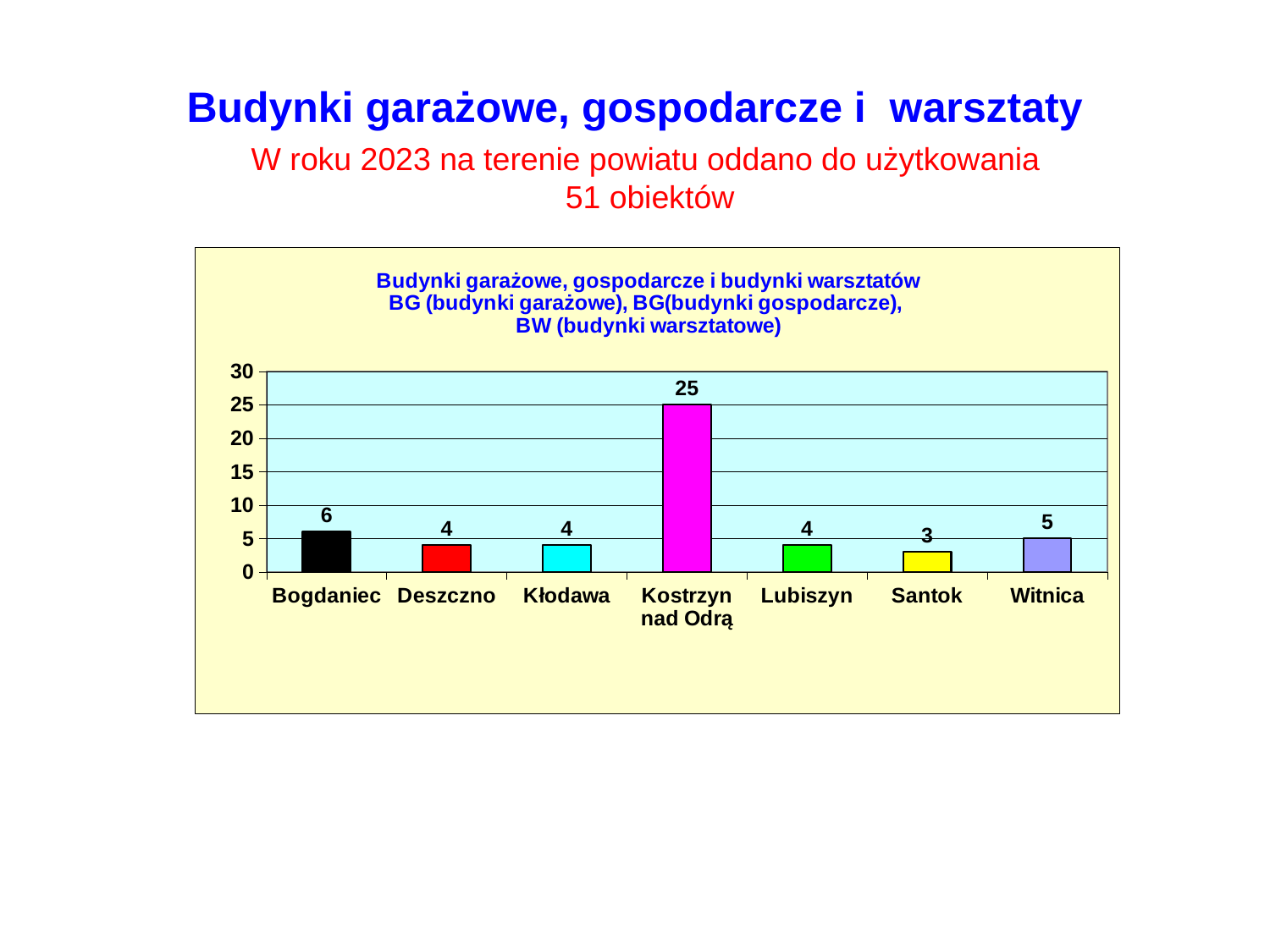
What kind of chart is shown on the slide? bar chart Which is larger, the value for Bogdaniec or the value for Deszczno? Bogdaniec Which category has the lowest value? Santok How many categories are shown on the x axis? 7 Which category has the highest value? Kostrzyn nad Odrą What is the value for Bogdaniec? 6 What is the difference between the values for Kostrzyn nad Odrą and Bogdaniec? 19 What is the value for Santok? 3 What is the value for Kostrzyn nad Odrą? 25 What is the difference between the values for Witnica and Santok? 2 Is the value for Kostrzyn nad Odrą greater or less than 20? greater What is the value for Witnica? 5